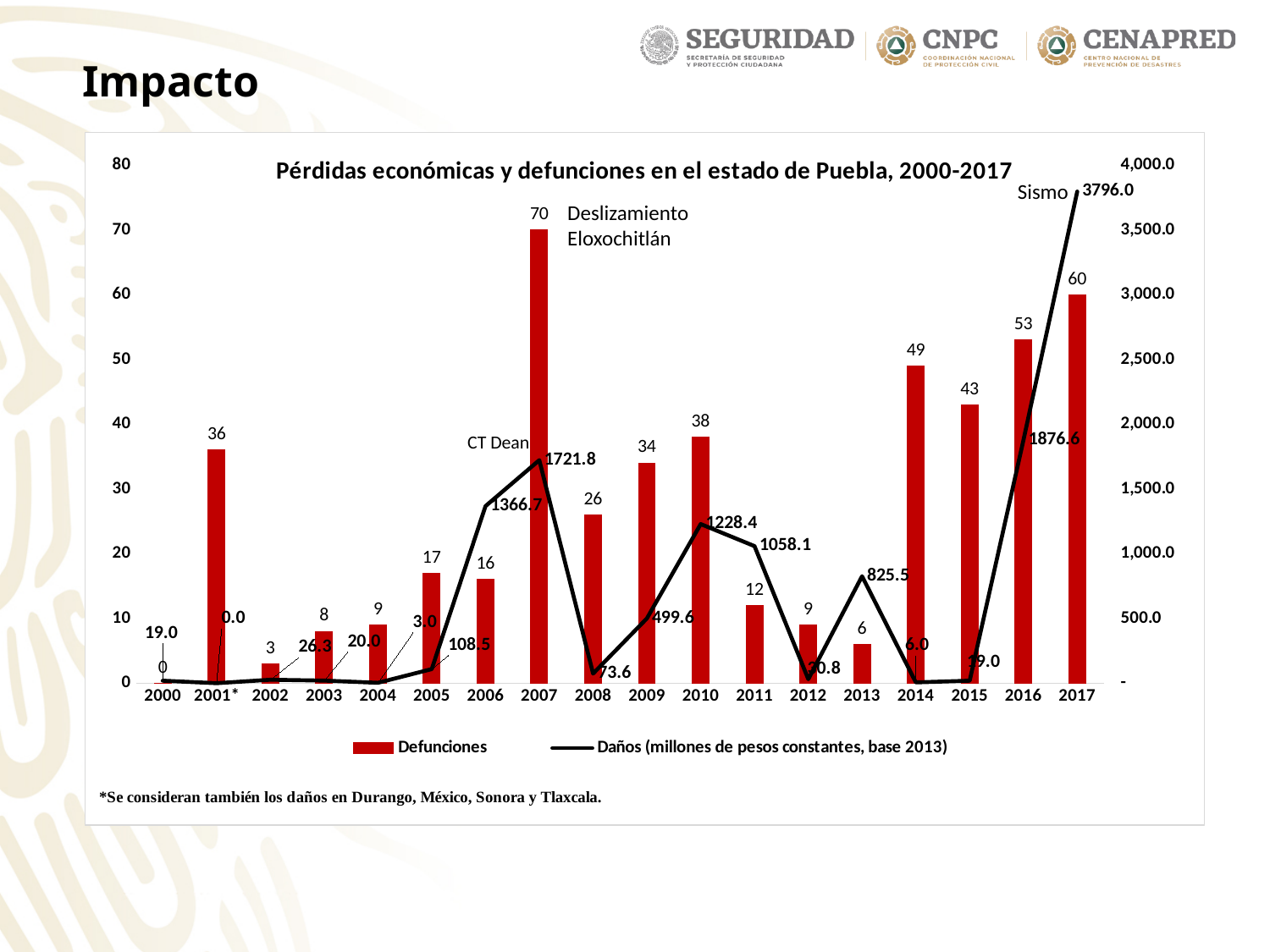
What is the value of Daños (millones de pesos constantes, base 2013) for 2017? 3796.0 What is the difference in Defunciones between 2017 and 2016? 7 Which year has the highest number of Defunciones? 2007 What is the value of Daños for 2007? 1721.8 Which year has the lowest number of Defunciones? 2000 What is the value of Defunciones for 2007? 70 What is the value of Defunciones for 2001*? 36 What kind of chart is shown on the slide? A combined bar and line chart How many series does the legend list? 2 Which year has more Defunciones, 2014 or 2015? 2014 How many years are shown on the x axis? 18 What event is annotated next to the 2017 peak of the Daños line? Sismo